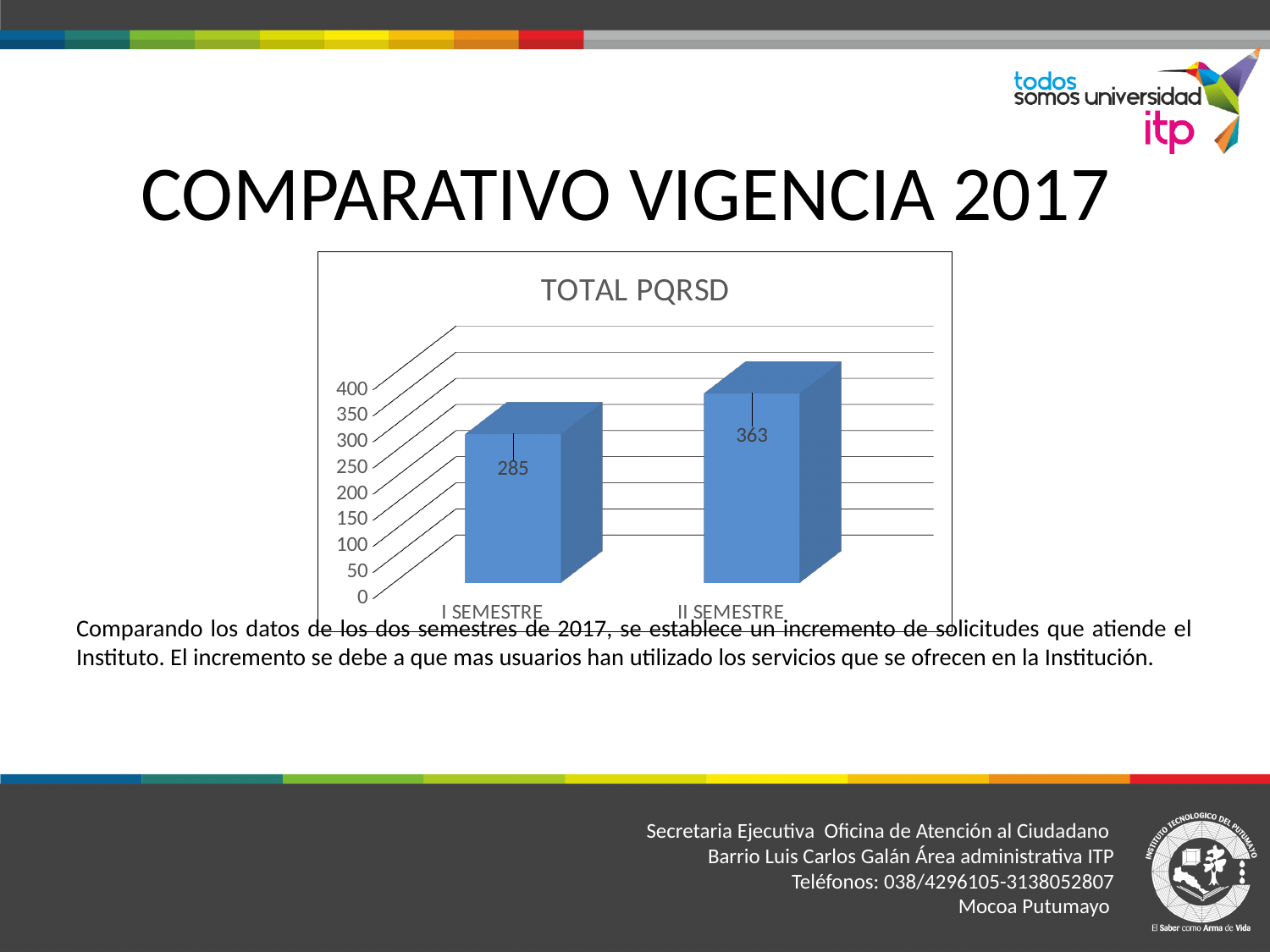
What is the title of the chart on the slide? TOTAL PQRSD What kind of chart is shown on the slide? bar chart Which semester has the highest value in the TOTAL PQRSD chart? II SEMESTRE Which is larger, the value for I SEMESTRE or II SEMESTRE? II SEMESTRE What is the difference between the values for II SEMESTRE and I SEMESTRE? 78 Which semester has the lowest value in the TOTAL PQRSD chart? I SEMESTRE Is the value for II SEMESTRE greater or less than 400? less Is the value for I SEMESTRE greater or less than 250? greater What is the value for II SEMESTRE in the TOTAL PQRSD chart? 363 What is the value for I SEMESTRE in the TOTAL PQRSD chart? 285 How many categories are shown in the TOTAL PQRSD chart? 2 Do the values rise or fall from I SEMESTRE to II SEMESTRE? rise